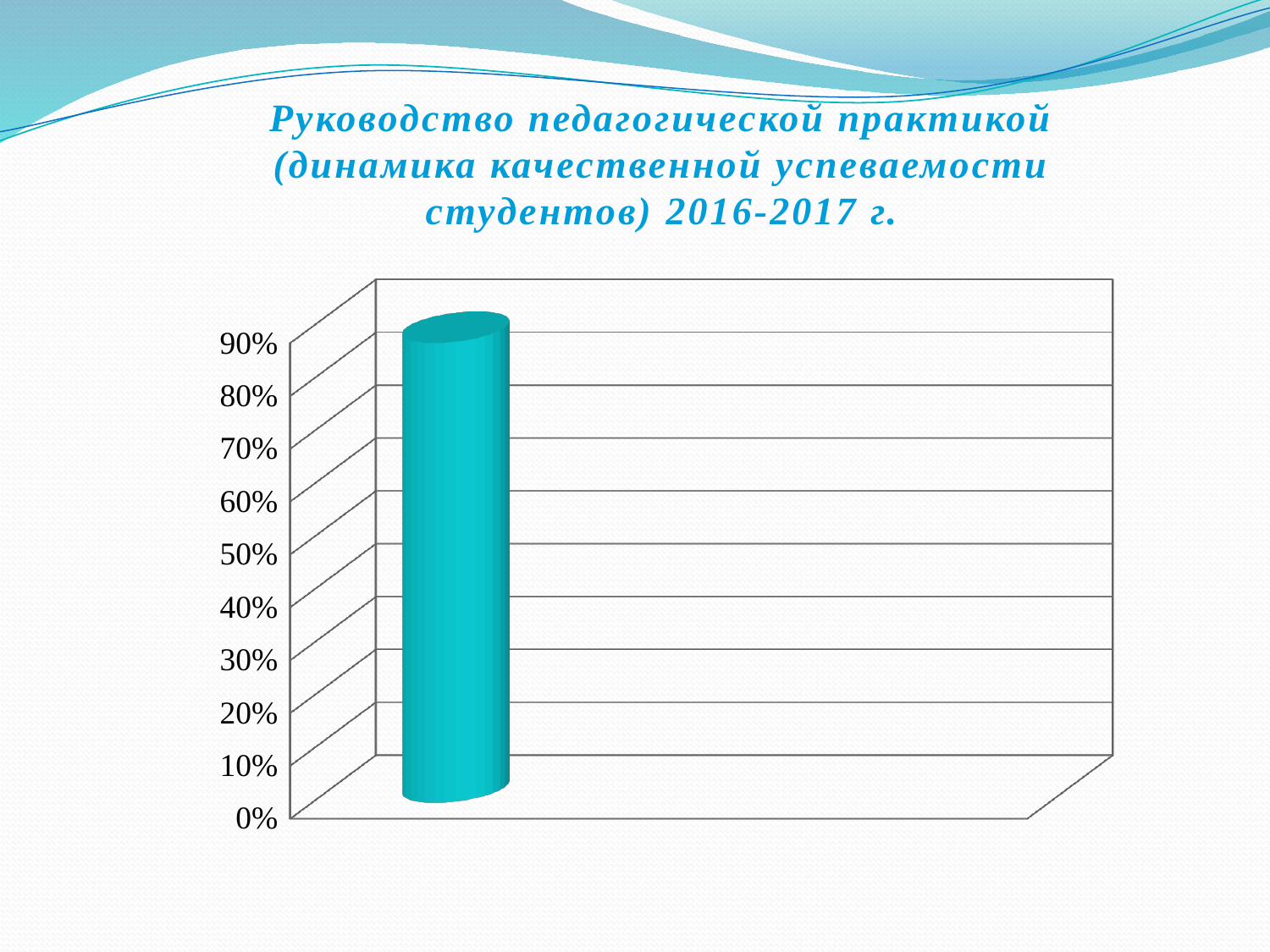
Is the value of the single bar greater or less than 30%? greater What is the highest tick label shown on the vertical axis? 90% Is the value of the single bar greater or less than 80%? greater What kind of chart is shown on the slide? bar chart How many bars are plotted in the chart? 1 What colour is the bar in the chart? teal Is the value of the single bar greater or less than 50%? greater